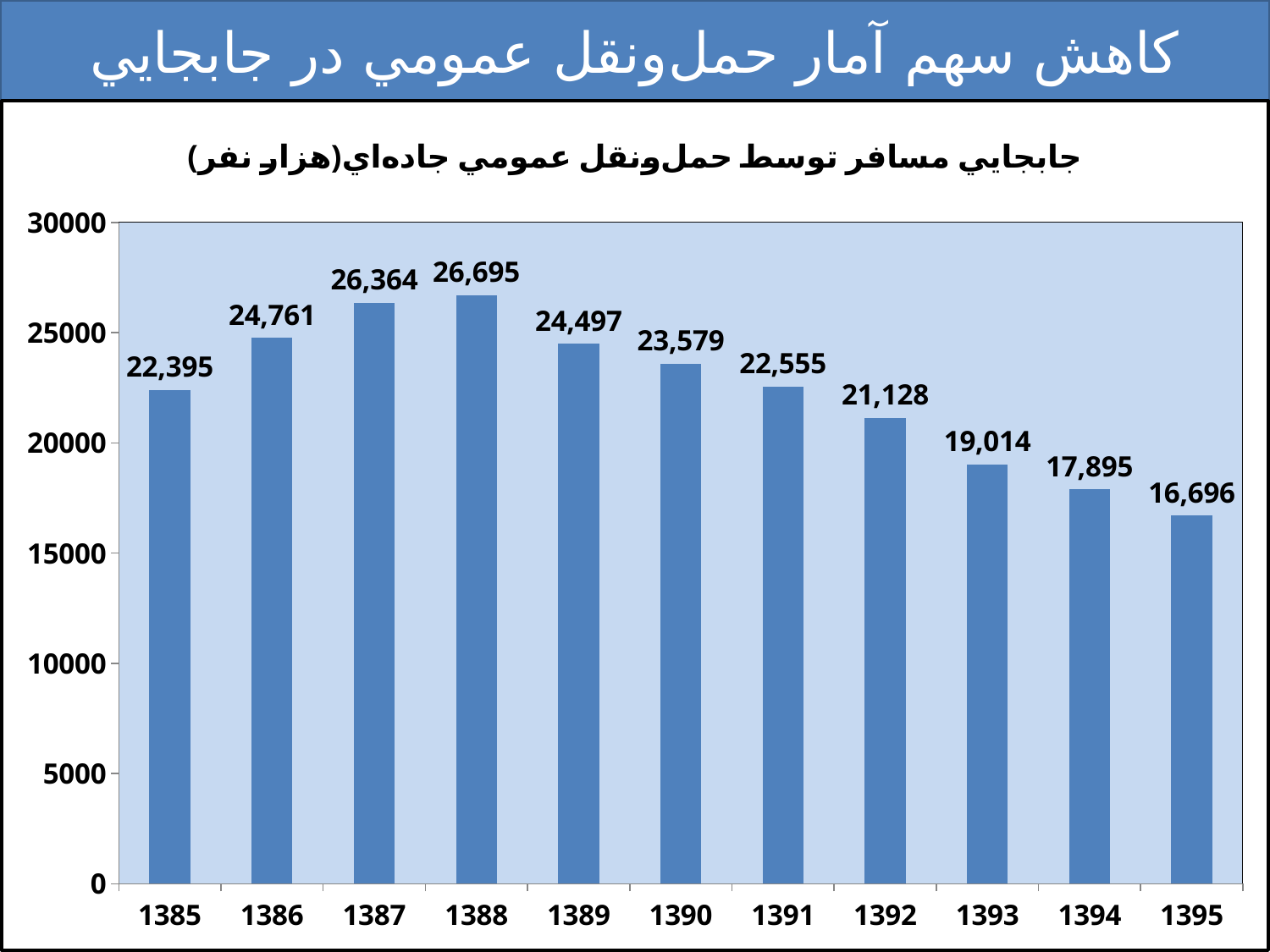
How many years are shown on the x axis? 11 Which year has the lowest value? 1395 Which is larger, the value for 1385 or the value for 1391? 1391 Which year has the highest value? 1388 Is the value for 1393 greater or less than 20000? less What is the difference between the values for 1388 and 1395? 9,999 What is the value for 1388? 26,695 What is the value for 1395? 16,696 What is the difference between the values for 1386 and 1387? 1,603 What is the value for 1391? 22,555 What kind of chart is shown on the slide? bar chart Do the values rise or fall from 1388 to 1395? fall